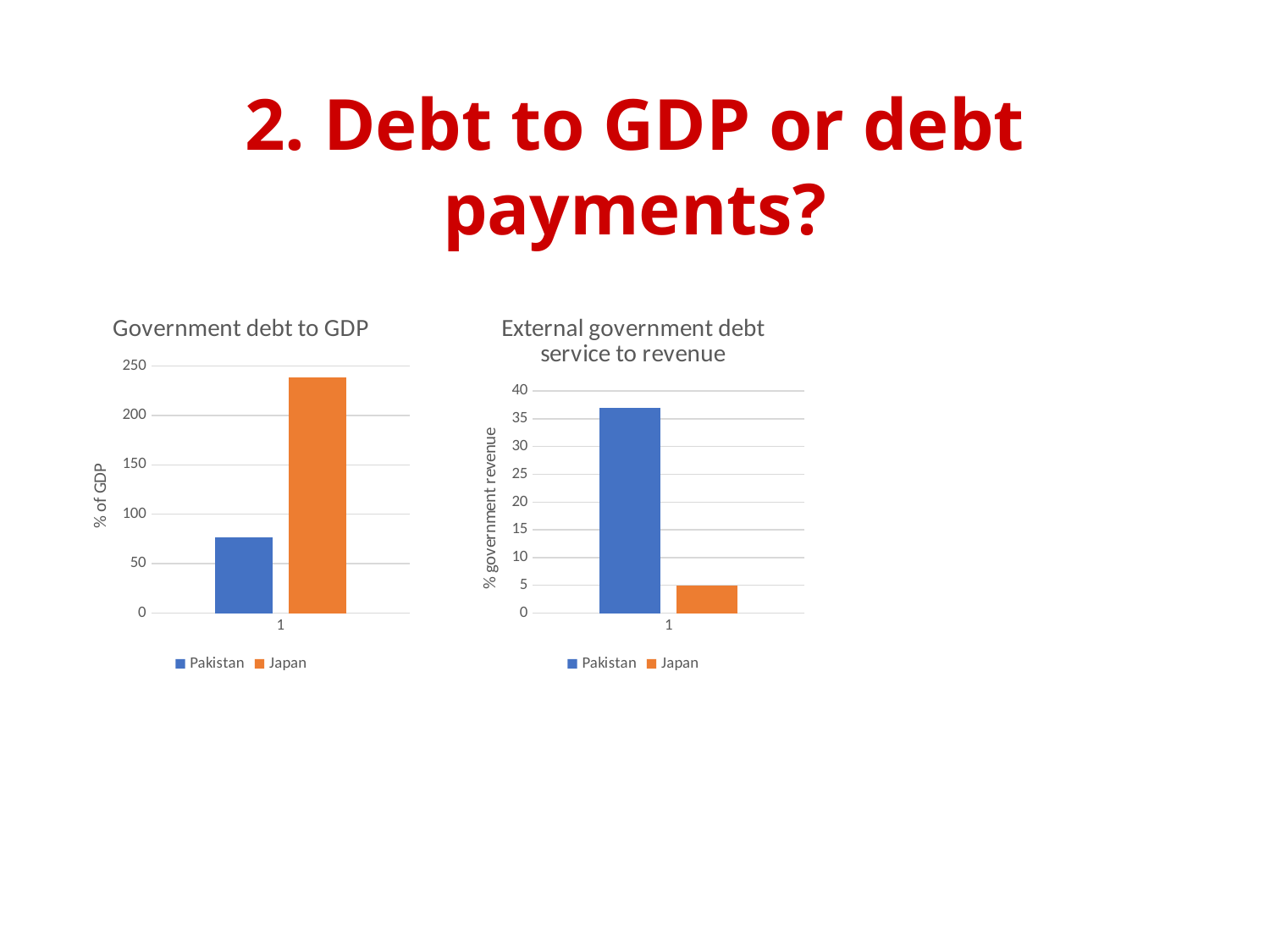
In the 'External government debt service to revenue' chart, is the value for Pakistan greater or less than 30? greater In the 'Government debt to GDP' chart, is the value for Japan greater or less than 200? greater In the 'External government debt service to revenue' chart, is the value for Japan greater or less than 10? less In the 'External government debt service to revenue' chart, how many series does the legend list? 2 In the 'Government debt to GDP' chart, what is the label on the vertical axis? % of GDP In the 'External government debt service to revenue' chart, which country has the highest value? Pakistan In the 'Government debt to GDP' chart, what kind of chart is shown? bar chart In the 'External government debt service to revenue' chart, what is the label on the vertical axis? % government revenue In the 'Government debt to GDP' chart, how many series does the legend list? 2 In the 'Government debt to GDP' chart, which country has the higher value, Pakistan or Japan? Japan In the 'External government debt service to revenue' chart, which country has the lowest value? Japan